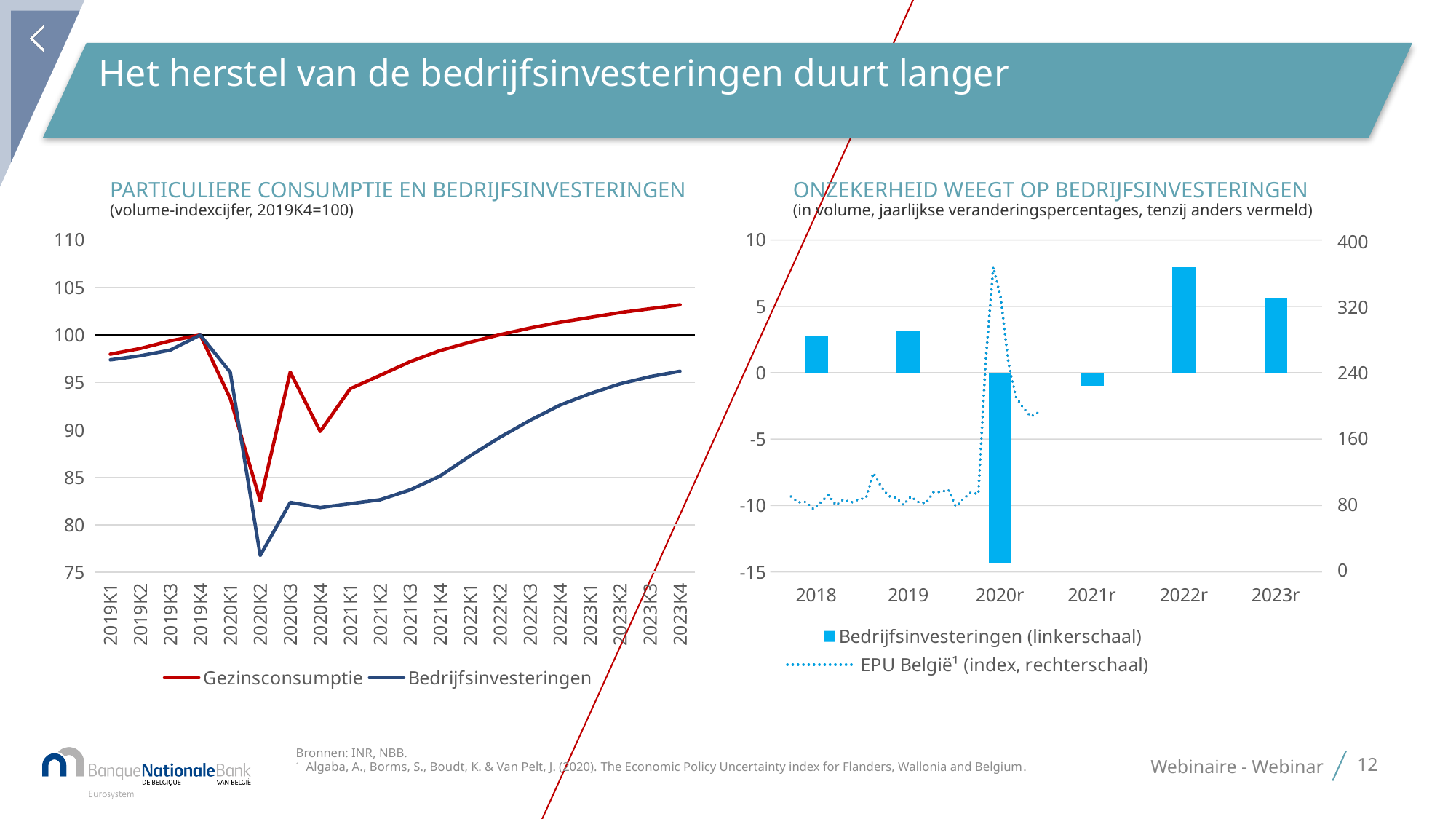
In the left chart 'Particuliere consumptie en bedrijfsinvesteringen', does Bedrijfsinvesteringen rise or fall from 2020K2 to 2023K4? rise In the left chart 'Particuliere consumptie en bedrijfsinvesteringen', what is the value of Gezinsconsumptie in 2019K4? 100 What kind of chart is the left chart, 'Particuliere consumptie en bedrijfsinvesteringen'? line chart In the right chart 'Onzekerheid weegt op bedrijfsinvesteringen', what is the highest value shown on the right-hand axis? 400 How many series does the legend of the left chart 'Particuliere consumptie en bedrijfsinvesteringen' list? 2 In the left chart 'Particuliere consumptie en bedrijfsinvesteringen', is the value of Bedrijfsinvesteringen in 2020K2 greater or less than 80? less In the right chart 'Onzekerheid weegt op bedrijfsinvesteringen', is the Bedrijfsinvesteringen value for 2020r greater or less than -10? less In the right chart 'Onzekerheid weegt op bedrijfsinvesteringen', which year has the highest Bedrijfsinvesteringen bar? 2022r In the left chart 'Particuliere consumptie en bedrijfsinvesteringen', which series is higher in 2023K4, Gezinsconsumptie or Bedrijfsinvesteringen? Gezinsconsumptie How many quarters are shown on the x axis of the left chart 'Particuliere consumptie en bedrijfsinvesteringen'? 20 In the left chart 'Particuliere consumptie en bedrijfsinvesteringen', in which quarter does Bedrijfsinvesteringen reach its lowest value? 2020K2 In the right chart 'Onzekerheid weegt op bedrijfsinvesteringen', which year has the lowest Bedrijfsinvesteringen bar? 2020r